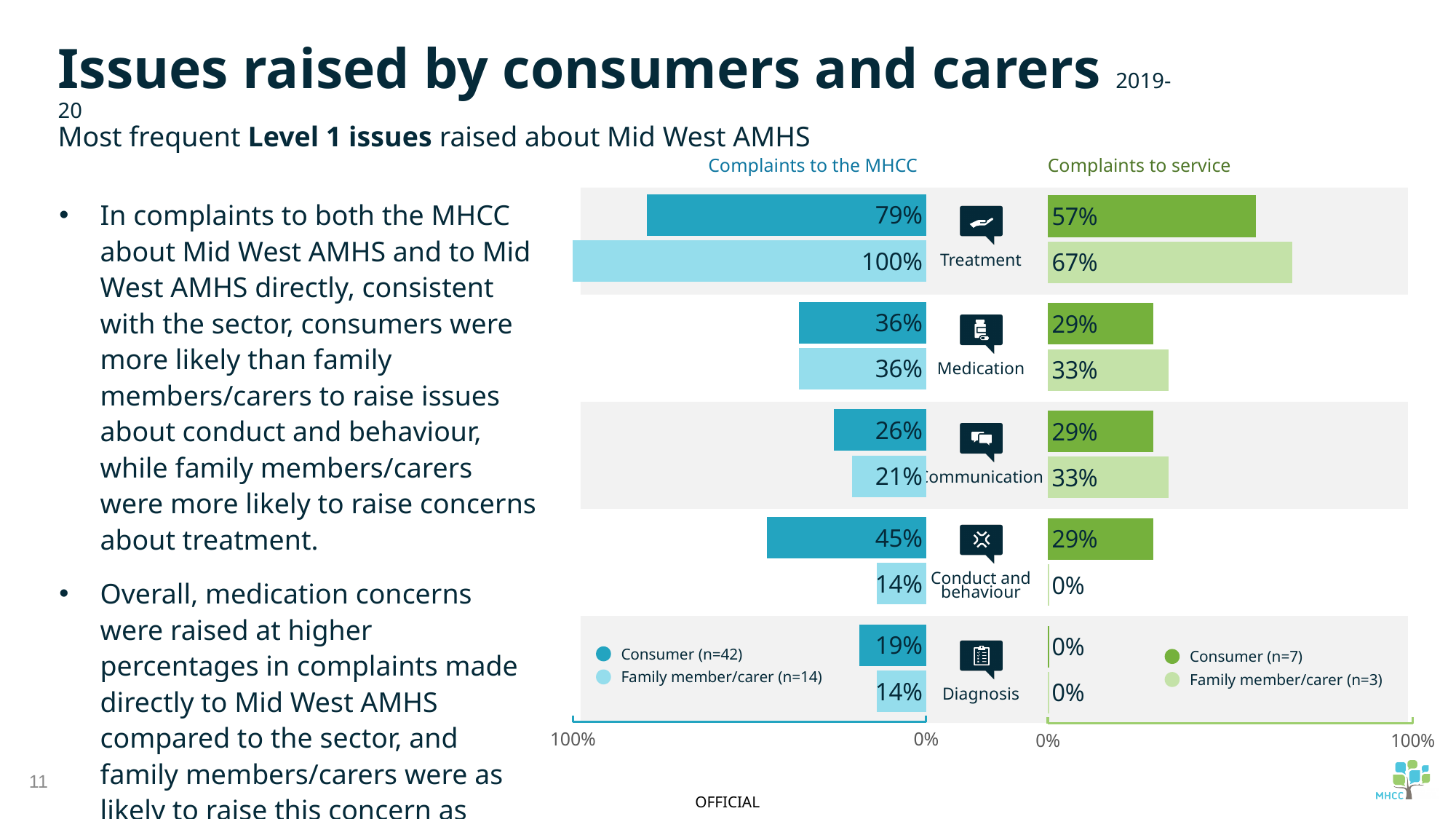
According to the legend of the 'Complaints to service' chart, how many consumers are in the sample? n=7 In the 'Complaints to the MHCC' chart, which issue has the lowest consumer percentage? Diagnosis In the 'Complaints to the MHCC' chart, which issue has the highest consumer percentage? Treatment In the 'Complaints to service' chart, what percentage of family member/carer complaints raised Conduct and behaviour? 0% What type of chart is the 'Complaints to the MHCC' chart? Bar chart In the 'Complaints to the MHCC' chart, what is the difference between the consumer and family member/carer percentages for Conduct and behaviour? 31 percentage points How many series does the legend of the 'Complaints to service' chart list? 2 In the 'Complaints to the MHCC' chart, what percentage of family member/carer complaints raised Treatment? 100% In the 'Complaints to service' chart, what percentage of consumer complaints raised Treatment? 57% How many issue categories are shown in the 'Complaints to the MHCC' chart? 5 In the 'Complaints to the MHCC' chart, what percentage of consumer complaints raised Treatment? 79% In the 'Complaints to service' chart, which is larger for Medication: the consumer percentage or the family member/carer percentage? Family member/carer